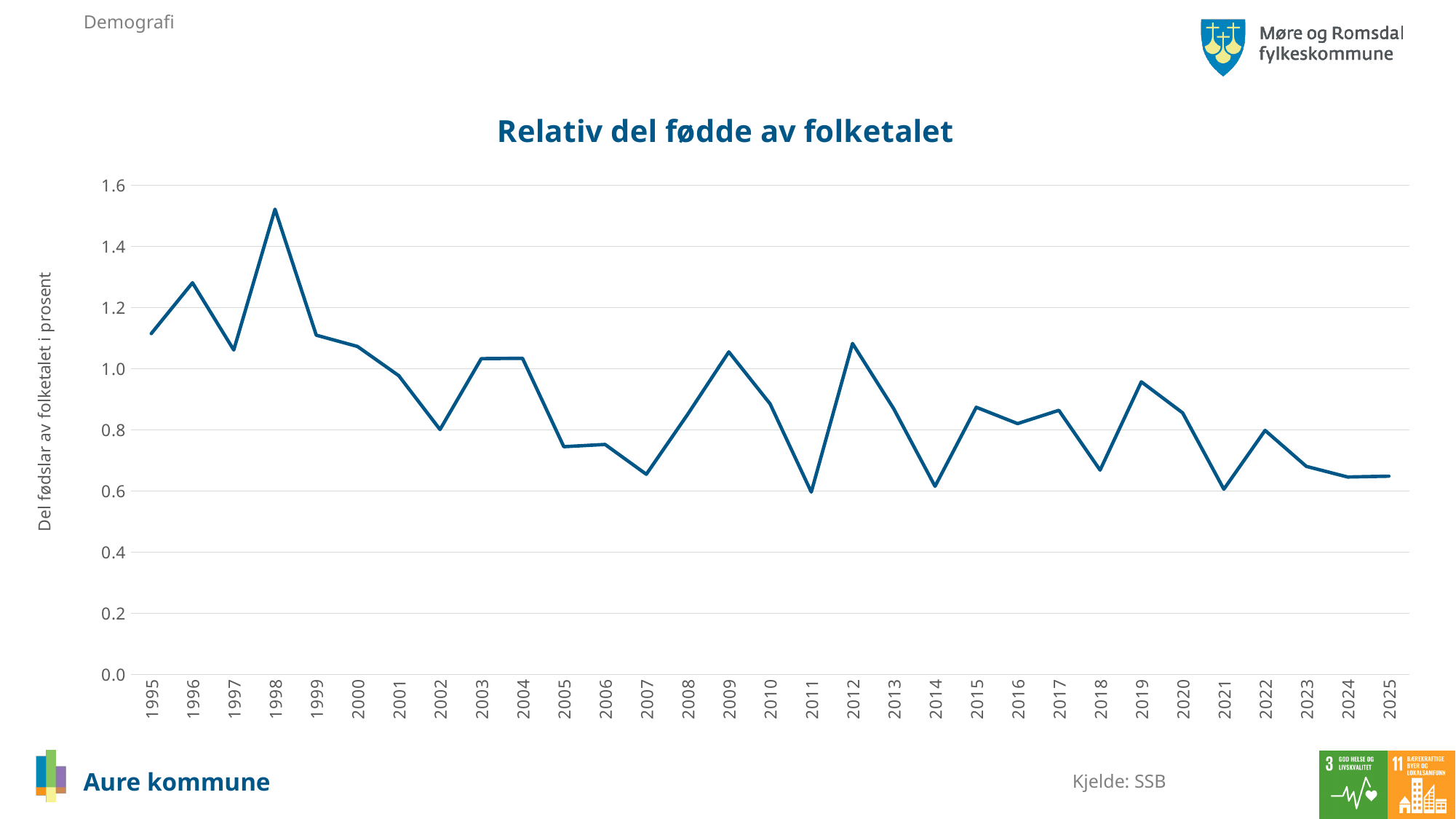
Is the value for 2012 greater or less than 1.0? greater What is the label on the y axis of the chart? Del fødslar av folketalet i prosent What kind of chart is shown on the slide? line chart Which year has the highest value on the chart? 1998 Is the value for 1998 greater or less than 1.4? greater Overall, do the values rise or fall from 1995 to 2025? fall Is the value for 2025 greater or less than 0.8? less What is the title of the chart? Relativ del fødde av folketalet Which year has the larger value, 2019 or 2021? 2019 How many years are plotted along the x axis? 31